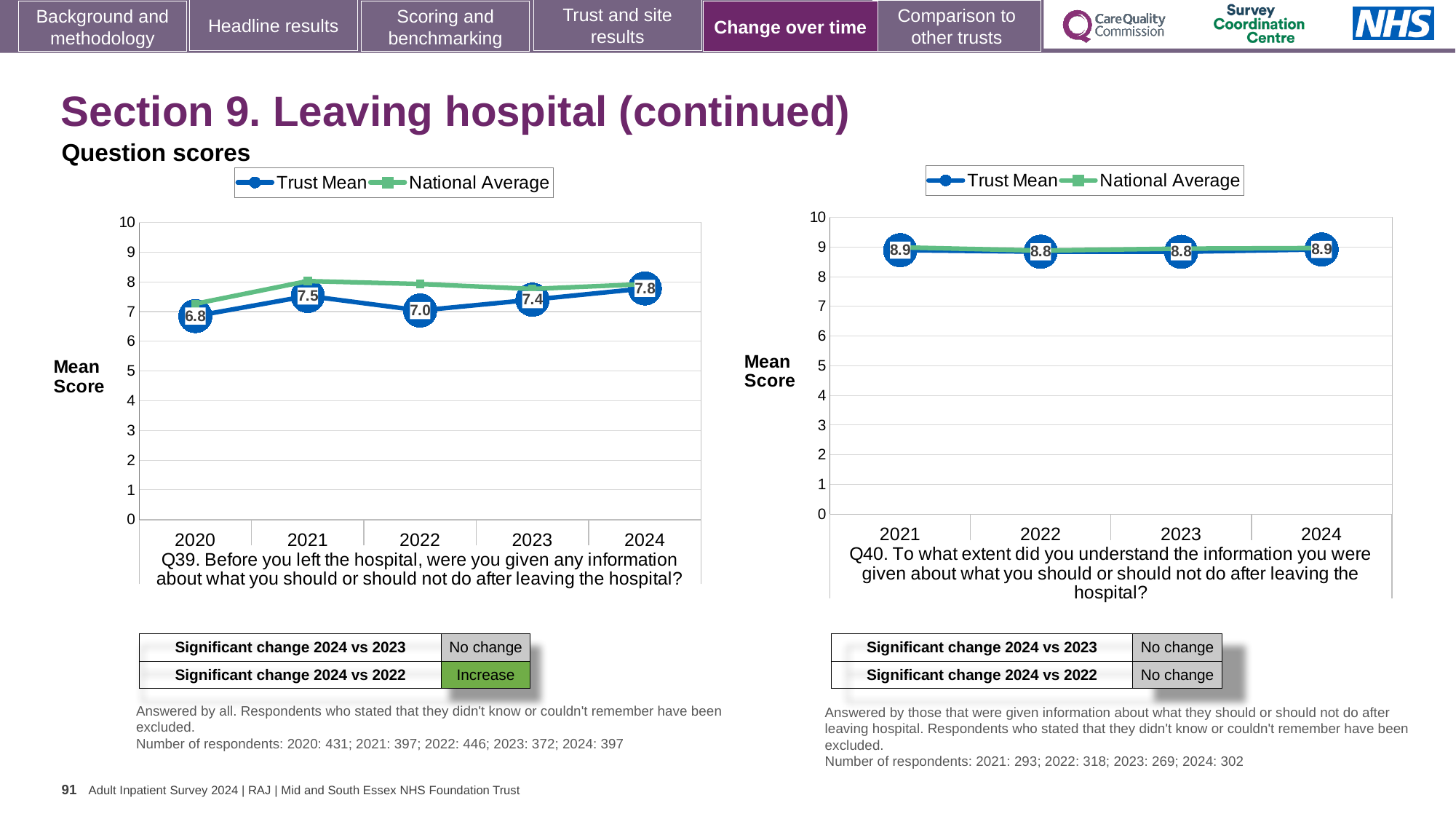
In the Q40 chart on the right, what is the Trust Mean score for 2022? 8.8 How many years are plotted on the x axis of the Q39 chart on the left? 5 In the Q39 chart on the left, is the Trust Mean score for 2021 larger than the Trust Mean score for 2022? Yes How many series does the legend of the Q40 chart on the right list? 2 In the Q39 chart on the left, what is the difference between the Trust Mean scores for 2024 and 2020? 1.0 In the Q39 chart on the left, what is the Trust Mean score for 2024? 7.8 In the Q40 chart on the right, what is the difference between the Trust Mean scores for 2024 and 2023? 0.1 In the Q39 chart on the left, what is the Trust Mean score for 2020? 6.8 In the Q39 chart on the left, which year has the lowest Trust Mean score? 2020 In the Q39 chart on the left, is the National Average for 2021 greater or less than 7? greater In the Q39 chart on the left, which year has the highest Trust Mean score? 2024 What type of chart is the Q40 chart on the right? Line chart